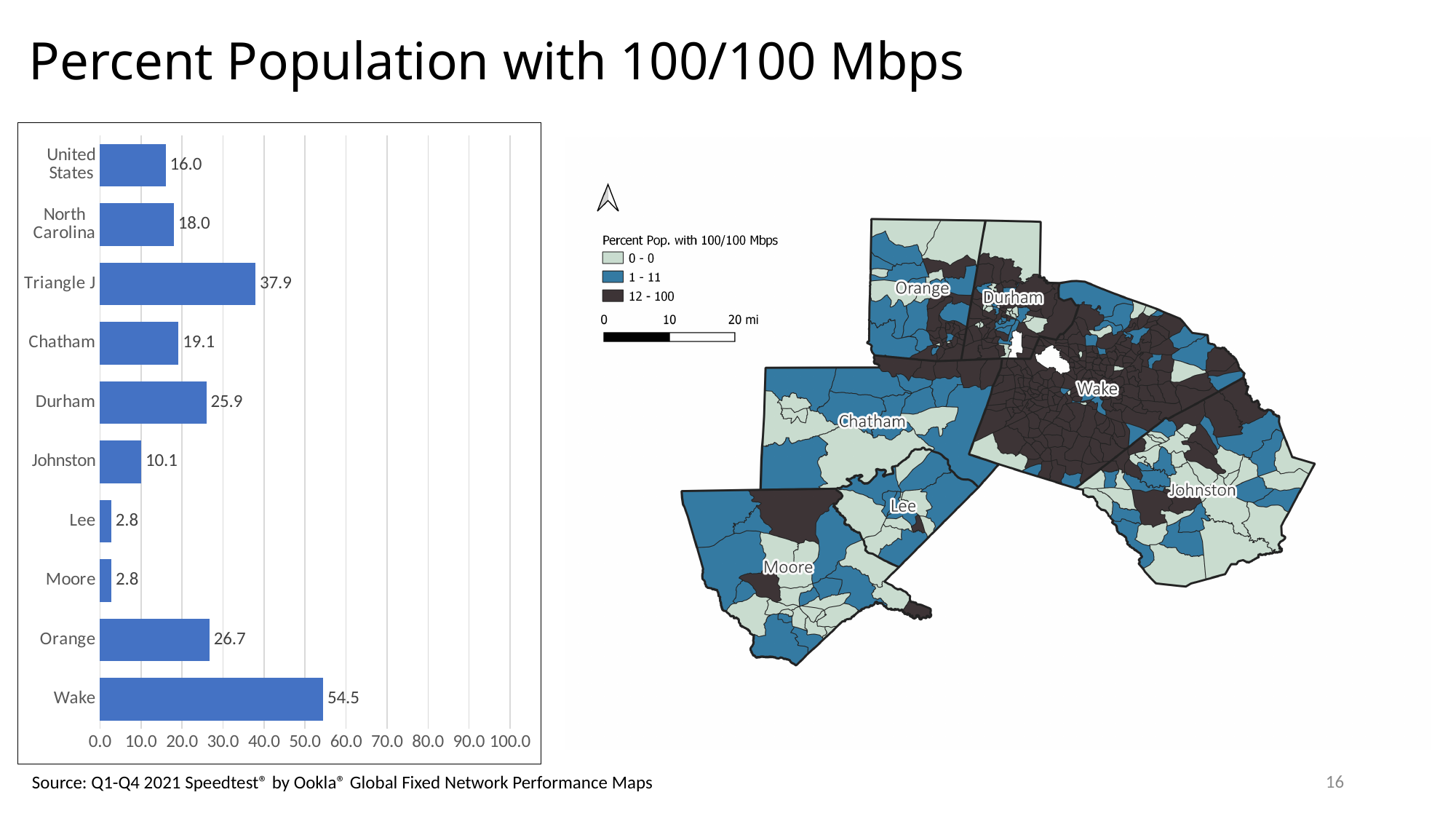
Is the value for Johnston in the bar chart greater or less than 20.0? less What is the difference between the values for Triangle J and the United States in the bar chart? 21.9 How many categories are shown in the bar chart? 10 What is the value for Triangle J in the bar chart? 37.9 Which category has the highest value in the bar chart? Wake What is the value for Lee in the bar chart? 2.8 What is the title of the slide? Percent Population with 100/100 Mbps What kind of chart is on the left of the slide? bar chart What is the difference between the values for Wake and Durham in the bar chart? 28.6 What is the value for Wake in the bar chart? 54.5 Which is larger in the bar chart, Orange or Chatham? Orange What is the value for North Carolina in the bar chart? 18.0